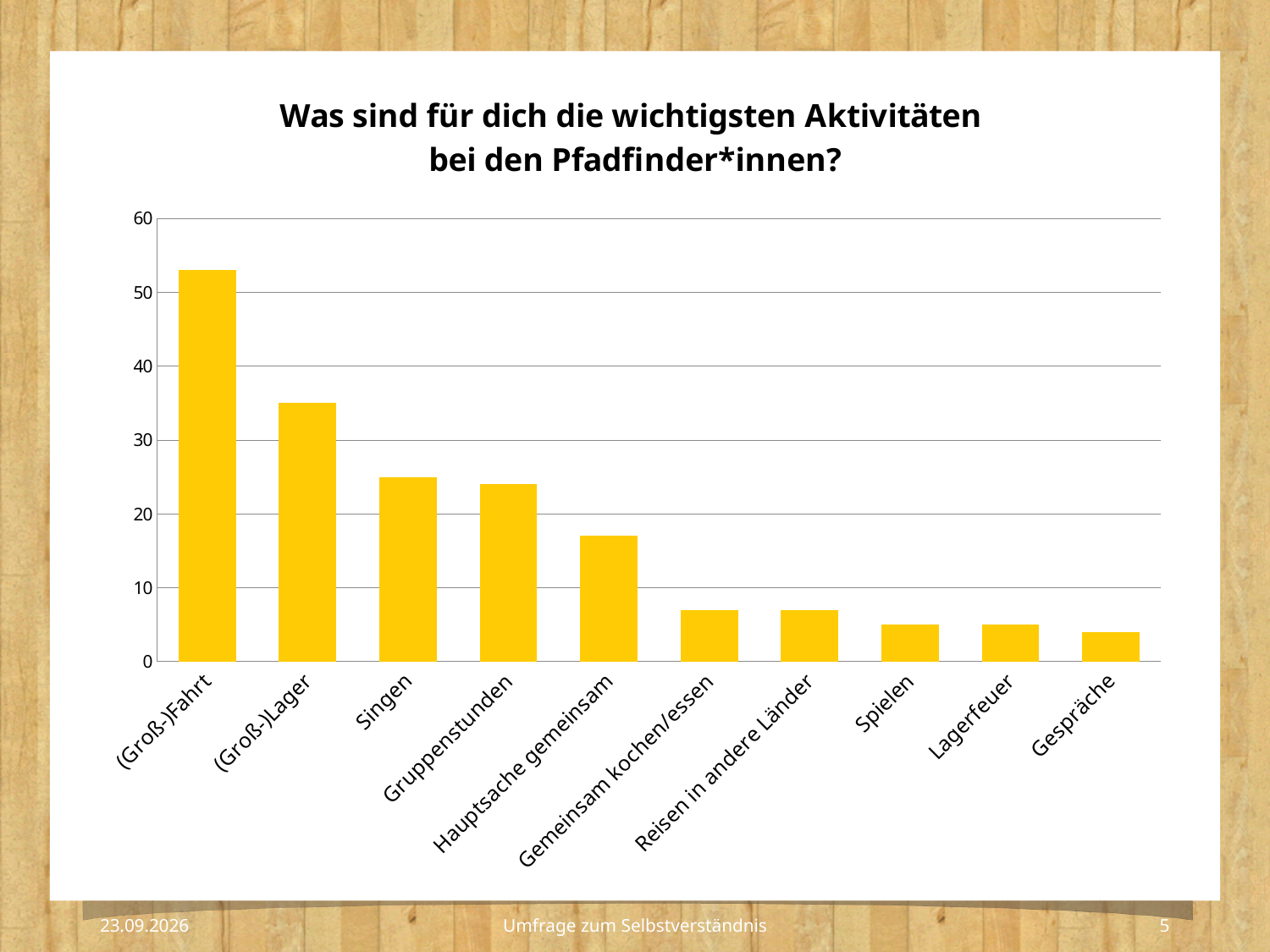
What is the title of the chart? Was sind für dich die wichtigsten Aktivitäten bei den Pfadfinder*innen? Do the values generally rise or fall from left to right along the x axis? fall Is the value for (Groß-)Lager greater or less than 30? greater How many categories are shown on the x axis of the chart? 10 What kind of chart is shown on the slide? bar chart Which category has the highest value in the chart? (Groß-)Fahrt Which is larger, the value for (Groß-)Fahrt or the value for (Groß-)Lager? (Groß-)Fahrt Is the value for Gemeinsam kochen/essen greater or less than 10? less Is the value for Hauptsache gemeinsam greater or less than 20? less Which is larger, the value for Singen or the value for Hauptsache gemeinsam? Singen